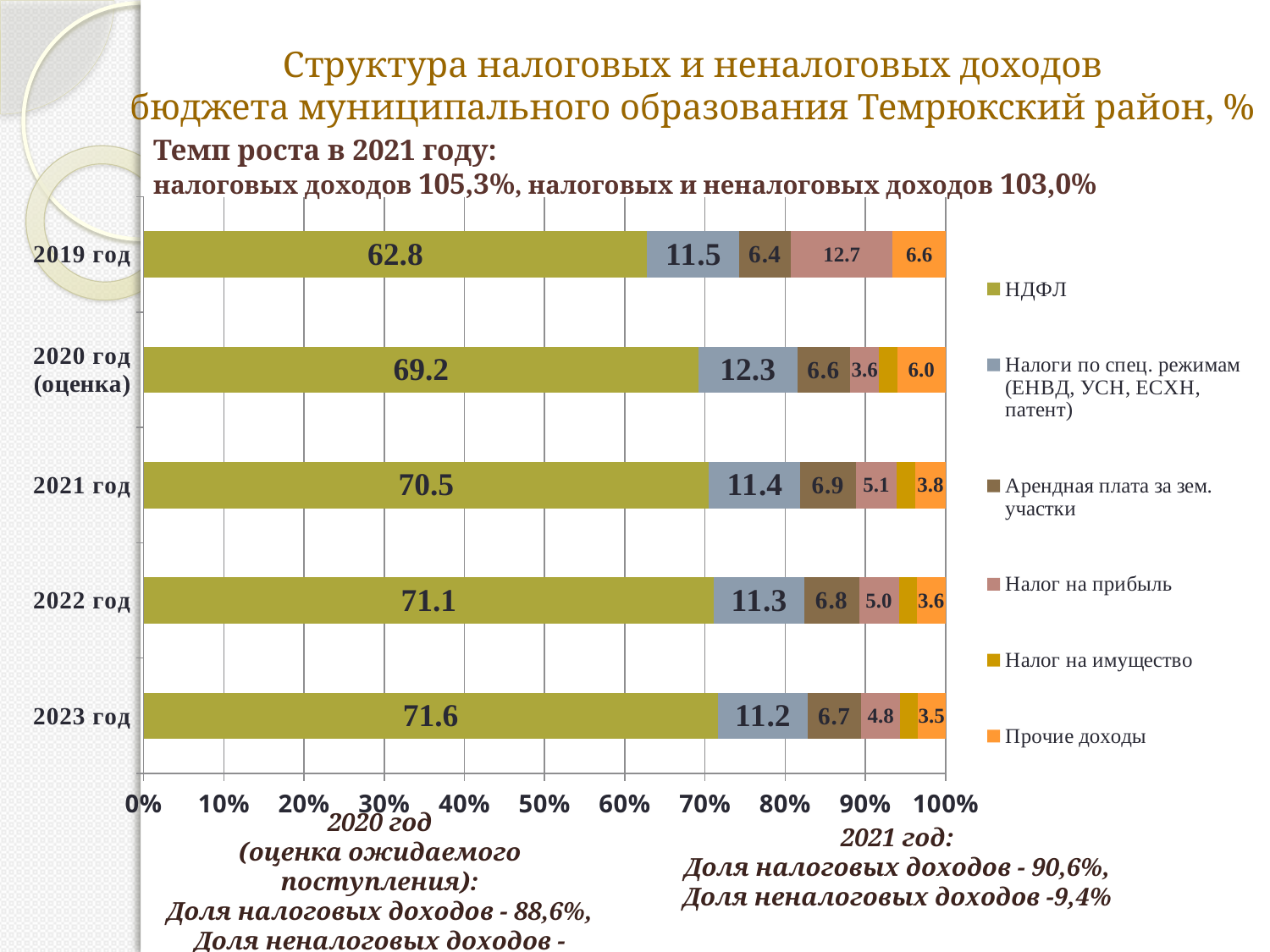
Which year has the lowest value for НДФЛ? 2019 год What kind of chart is shown on the slide? stacked bar chart What is the value for Налог на прибыль in 2019 год? 12.7 Does the НДФЛ share rise or fall from 2019 год to 2023 год? rise How many series does the legend list? 6 What is the value for НДФЛ in 2019 год? 62.8 How many years (categories) are shown in the chart? 5 Which year has the larger value for Налоги по спец. режимам: 2020 год (оценка) or 2021 год? 2020 год (оценка) What is the value for Прочие доходы in 2023 год? 3.5 What is the value for Арендная плата за зем. участки in 2021 год? 6.9 Which year has the highest value for НДФЛ? 2023 год What is the difference between the НДФЛ value in 2023 год and in 2019 год? 8.8